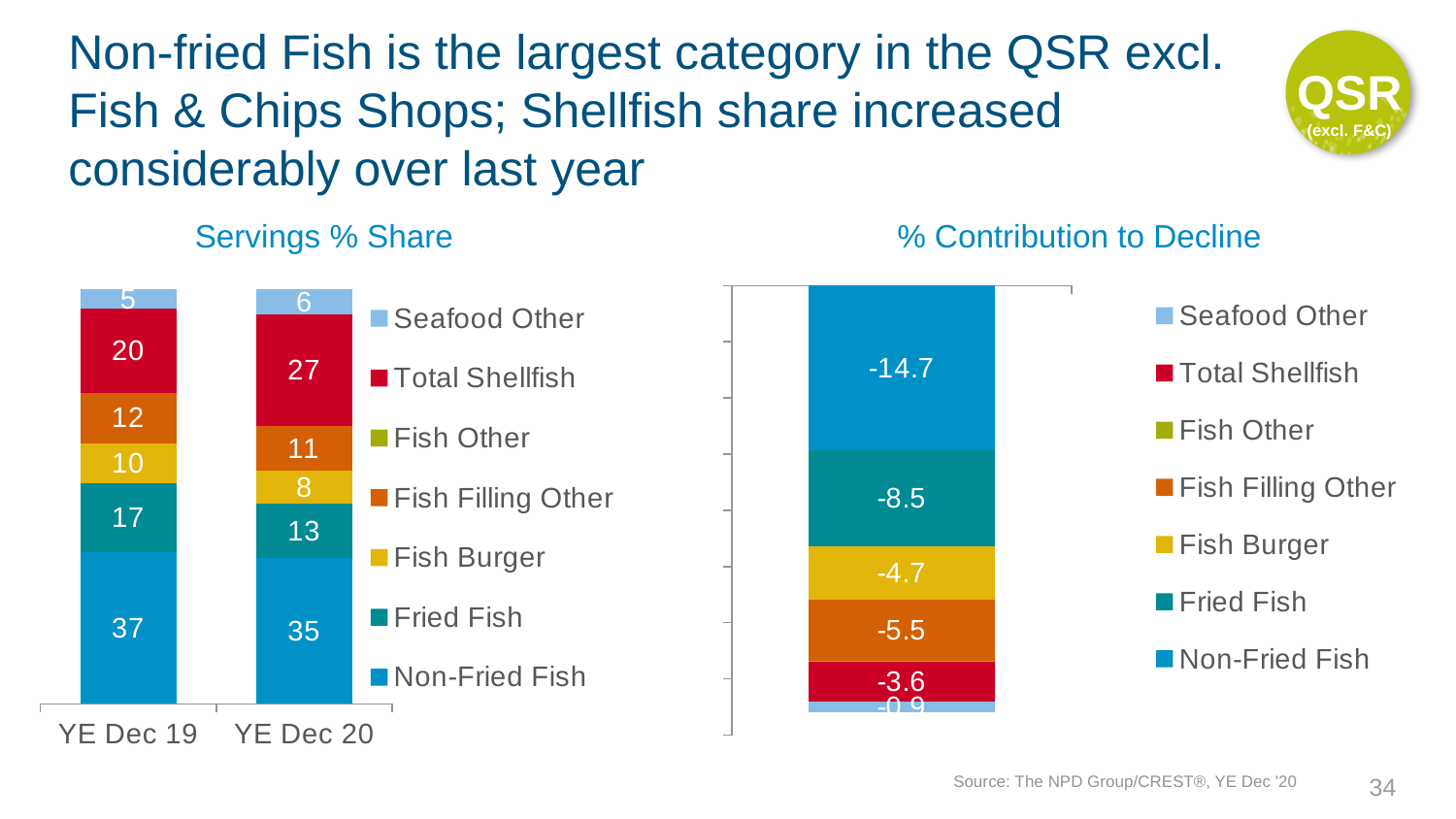
In the Servings % Share chart, what is the value for Non-Fried Fish in YE Dec 20? 35 In the % Contribution to Decline chart, what is the value for Non-Fried Fish? -14.7 In the Servings % Share chart, by how much did the Total Shellfish share increase from YE Dec 19 to YE Dec 20? 7 In the Servings % Share chart, what is the value for Total Shellfish in YE Dec 19? 20 In the Servings % Share chart, is the Fried Fish share larger in YE Dec 19 or YE Dec 20? YE Dec 19 What kind of chart is the Servings % Share chart? Stacked bar chart How many bars are shown in the Servings % Share chart? 2 In the Servings % Share chart, which category has the largest share in YE Dec 20? Non-Fried Fish In the Servings % Share chart, does the Non-Fried Fish share rise or fall from YE Dec 19 to YE Dec 20? Fall How many series does the legend of the Servings % Share chart list? 7 In the Servings % Share chart, which labelled category has the smallest share in YE Dec 19? Seafood Other In the % Contribution to Decline chart, what is the value for Fried Fish? -8.5